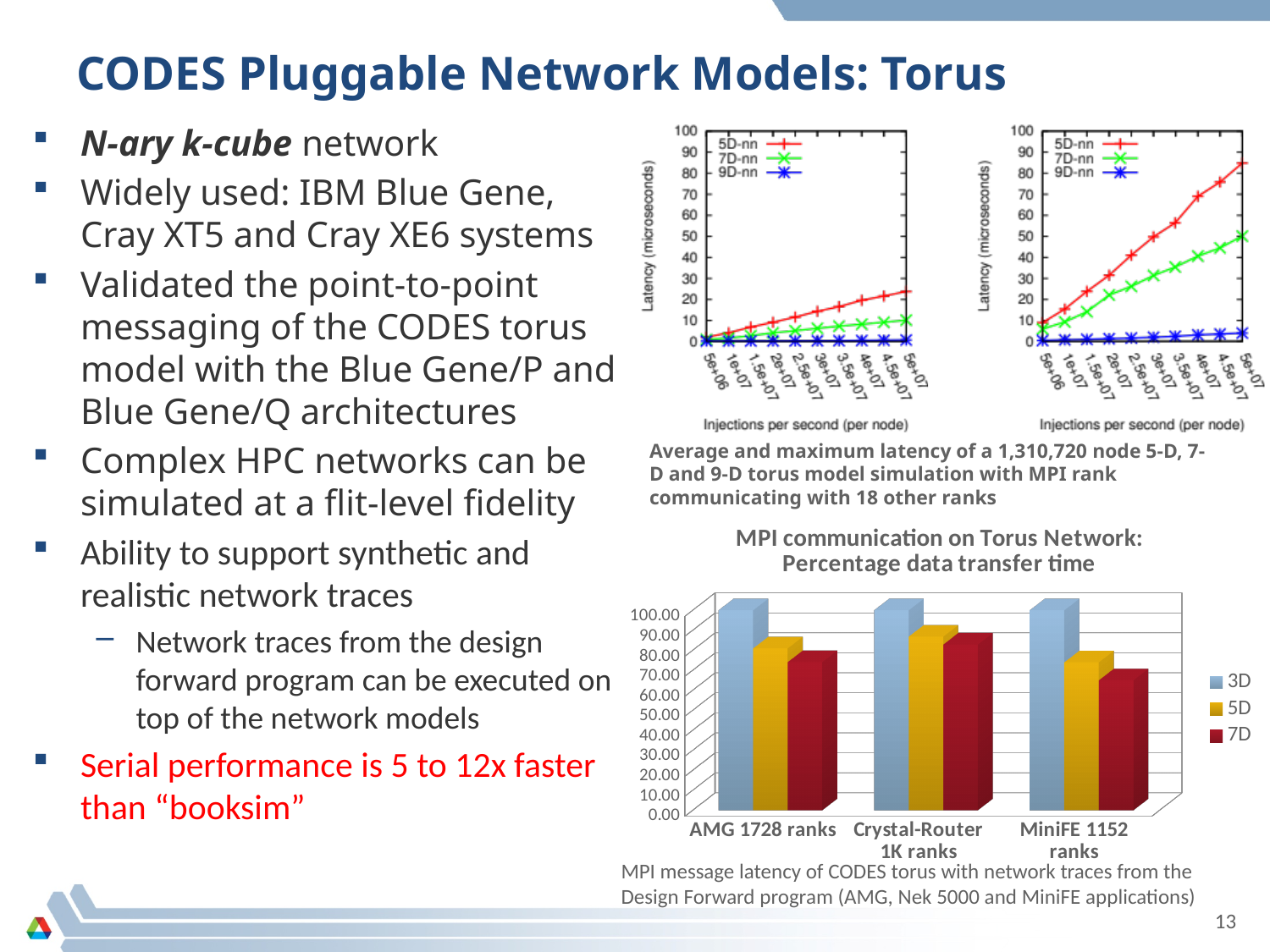
What are the legend entries of the 'MPI communication on Torus Network' bar chart? 3D, 5D, 7D In the 'MPI communication on Torus Network' bar chart, is the 7D value for MiniFE 1152 ranks greater or less than 80.00? less In the 'MPI communication on Torus Network' bar chart, is the 5D value for Crystal-Router 1K ranks greater or less than 80.00? greater In the left latency line chart, is the 5D-nn latency at 5e+07 injections per second greater or less than 30? less In the 'MPI communication on Torus Network' bar chart, is the 7D bar larger for Crystal-Router 1K ranks or for MiniFE 1152 ranks? Crystal-Router 1K ranks In the 'MPI communication on Torus Network' bar chart, for AMG 1728 ranks, which is larger: the 5D bar or the 7D bar? 5D How many categories are shown on the x axis of the 'MPI communication on Torus Network' bar chart? 3 How many series does the legend of the left latency line chart list? 3 In the right latency line chart, which series has the highest latency at 5e+07 injections per second? 5D-nn In the right latency line chart, does the 5D-nn series rise or fall as injections per second increase? rise What kind of chart is the 'MPI communication on Torus Network: Percentage data transfer time' chart? bar chart How many series does the legend of the 'MPI communication on Torus Network' bar chart list? 3